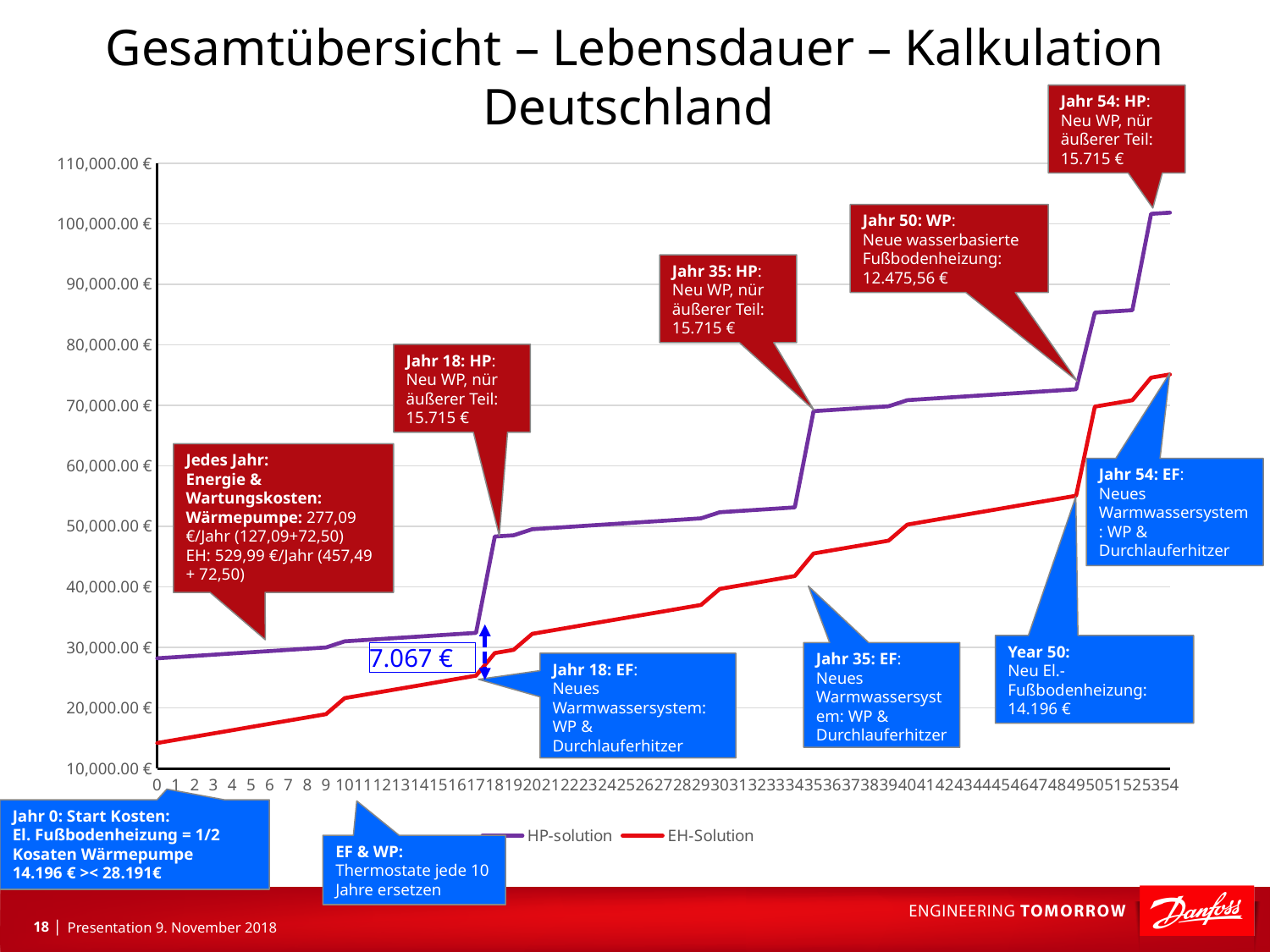
Do the values of the HP-solution series rise or fall along the x axis? rise What are the two series named in the legend? HP-solution and EH-Solution What kind of chart is shown on the slide? line chart Is the value of the EH-Solution series at year 54 greater or less than 70,000.00 €? greater Is the value of the HP-solution series at year 35 greater or less than 60,000.00 €? greater Is the value of the HP-solution series at year 54 greater or less than 90,000.00 €? greater At year 54, which series has the larger value, HP-solution or EH-Solution? HP-solution Do the values of the EH-Solution series rise or fall along the x axis? rise Which series is drawn in red? EH-Solution Which series reaches the highest value on the chart? HP-solution How many series does the legend list? 2